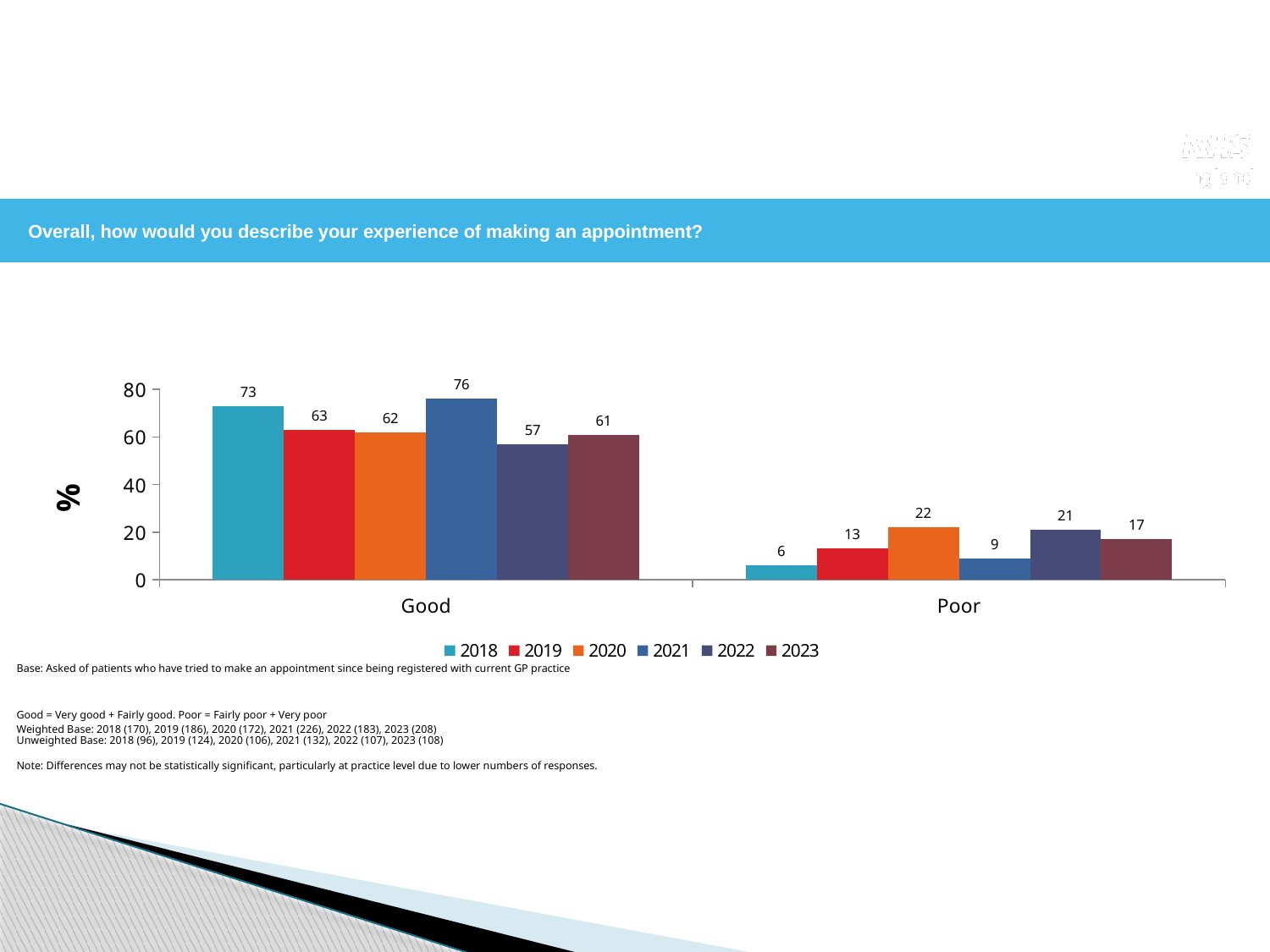
How many series does the legend list? 6 What is the value for 2018 in the Poor category? 6 Which year has the highest value in the Poor category? 2020 What is the difference between the 2021 and 2022 values in the Good category? 19 Which is larger: the 2019 value for Poor or the 2021 value for Poor? 2019 How many categories are shown on the x axis? 2 What is the value for 2021 in the Good category? 76 What is the value for 2023 in the Good category? 61 What is the label on the vertical axis? % What kind of chart is shown on the slide? Bar chart Which year has the lowest value in the Poor category? 2018 Which year has the highest value in the Good category? 2021